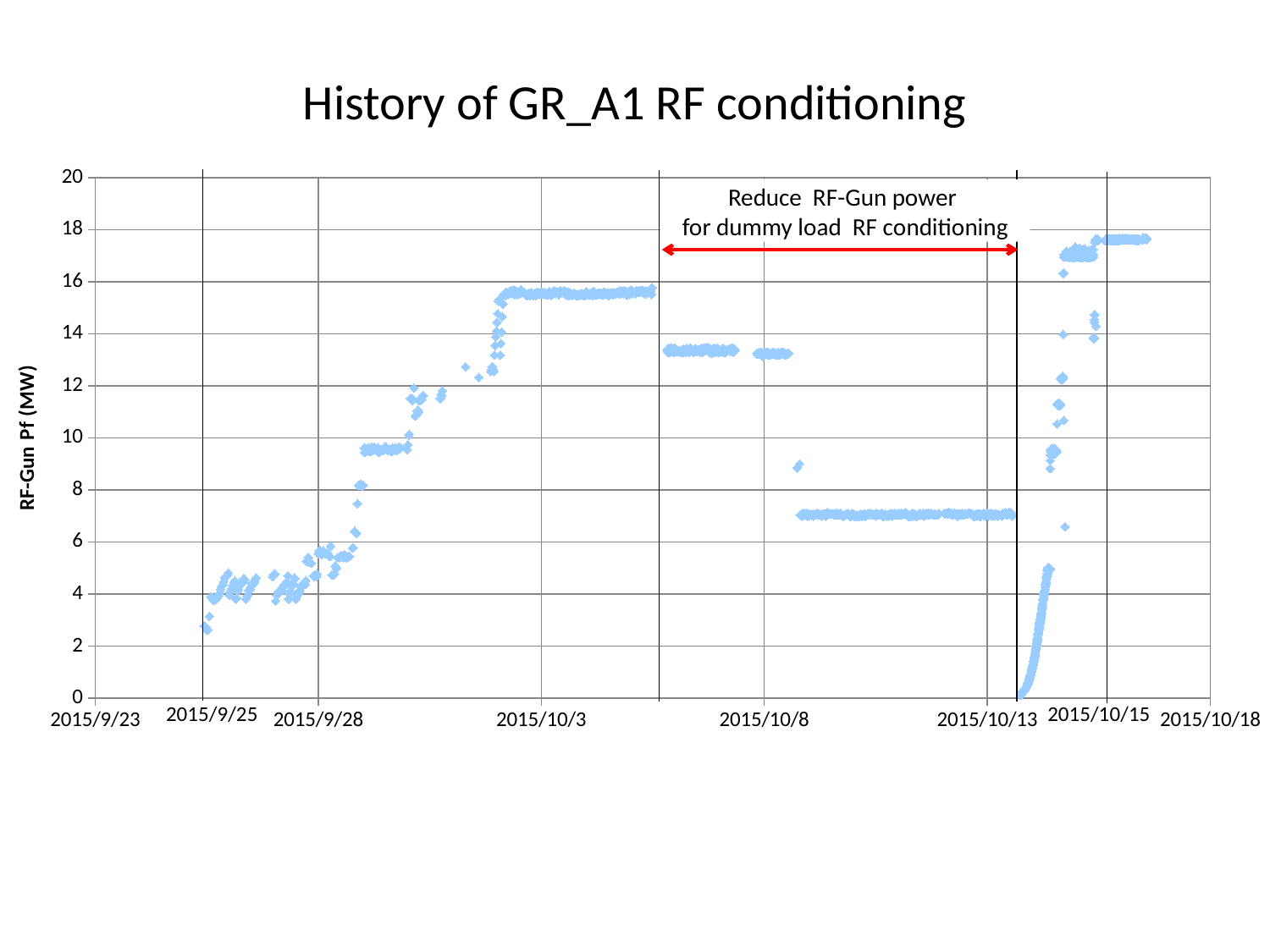
What is the label of the vertical axis? RF-Gun Pf (MW) Are the RF-Gun Pf values plotted around 2015/9/25 greater or less than 6 MW? less Are the RF-Gun Pf values plotted around 2015/10/3 greater or less than 14 MW? greater Do the RF-Gun Pf values generally rise or fall between 2015/9/25 and 2015/10/3? rise Are the RF-Gun Pf values plotted just after 2015/10/5 greater or less than 12 MW? greater What kind of chart is shown on the slide? scatter chart What is the title of the chart? History of GR_A1 RF conditioning What is the highest value shown on the vertical axis? 20 Is the RF-Gun Pf level between 2015/10/8 and 2015/10/13 higher or lower than the level around 2015/10/3? lower